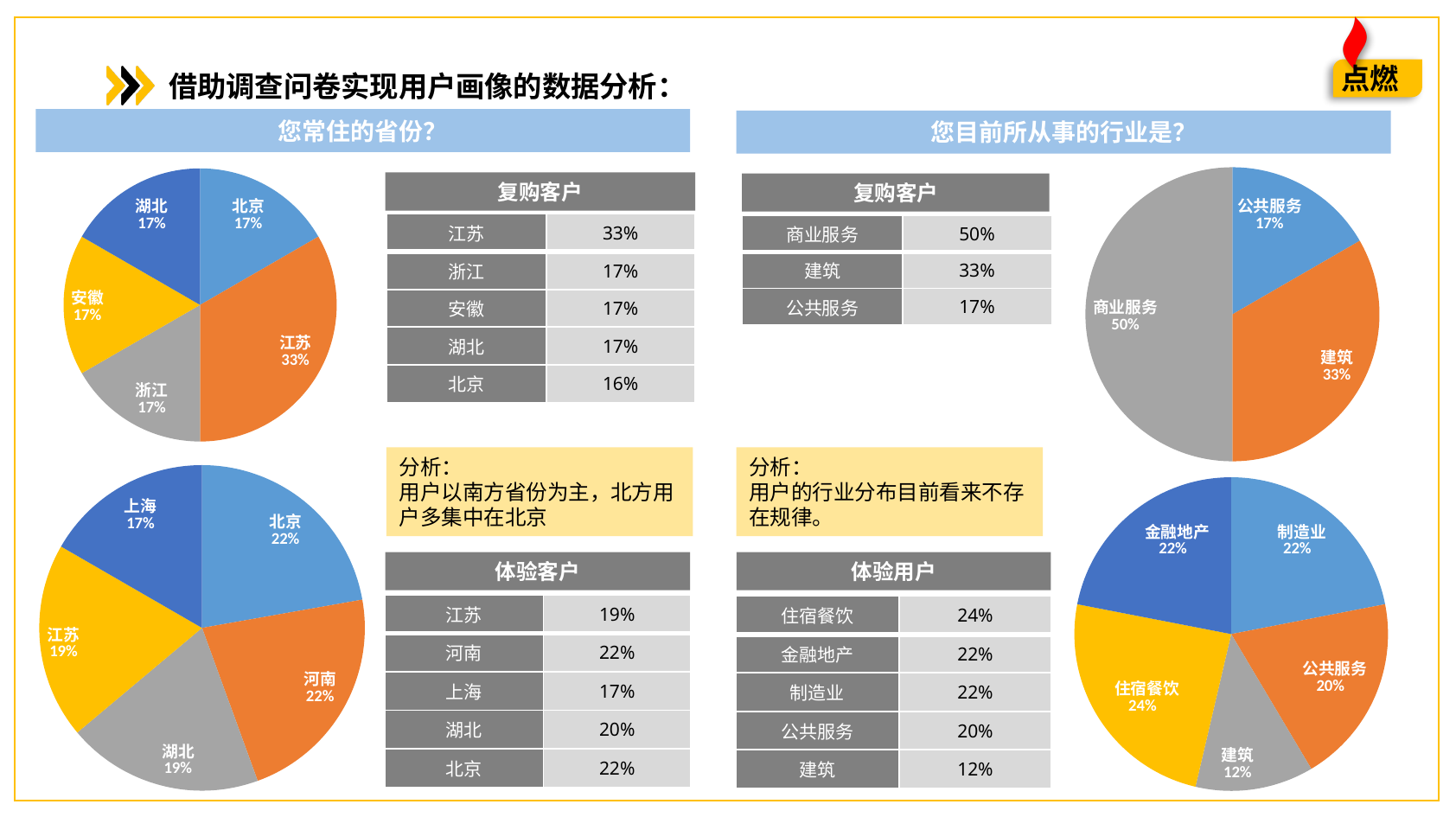
How many slices does the top-left pie chart have? 5 In the bottom-left pie chart, what is the value for 上海? 17% How many slices does the top-right pie chart have? 3 In the bottom-right pie chart, what is the difference between 住宿餐饮 and 建筑? 12% In the bottom-left pie chart, which category has the smallest slice? 上海 In the top-left pie chart, what is the value for 江苏? 33% In the top-right pie chart, which category has the smallest slice? 公共服务 In the bottom-right pie chart, which category has the largest slice? 住宿餐饮 In the top-right pie chart, what is the difference between 商业服务 and 建筑? 17% In the top-right pie chart, what is the value for 商业服务? 50% What kind of chart is the bottom-right chart on the slide? Pie chart In the top-left pie chart, which category has the largest slice? 江苏